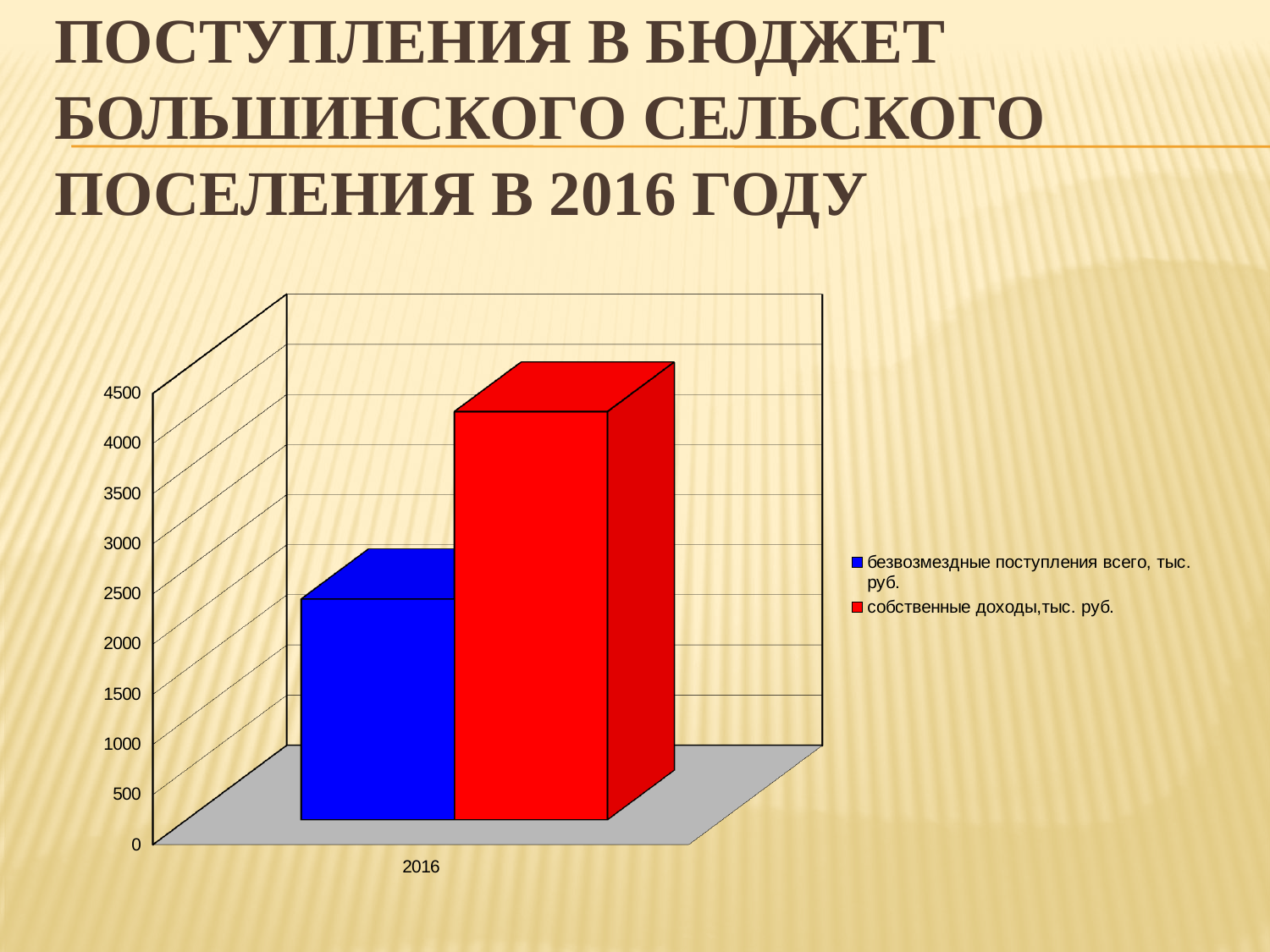
What colour is the bar for собственные доходы,тыс. руб.? red How many series does the legend list? 2 Is the value for безвозмездные поступления всего in 2016 greater or less than 2000? greater Is the value for собственные доходы in 2016 greater or less than 4500? less How many categories are shown on the x axis? 1 Is the value for безвозмездные поступления всего in 2016 greater or less than 3000? less What kind of chart is shown on the slide? bar chart Which series has the higher value in 2016? собственные доходы,тыс. руб. Which category label appears on the x axis? 2016 Which series has the lower value in 2016? безвозмездные поступления всего, тыс. руб. Which is larger in 2016: безвозмездные поступления всего or собственные доходы? собственные доходы